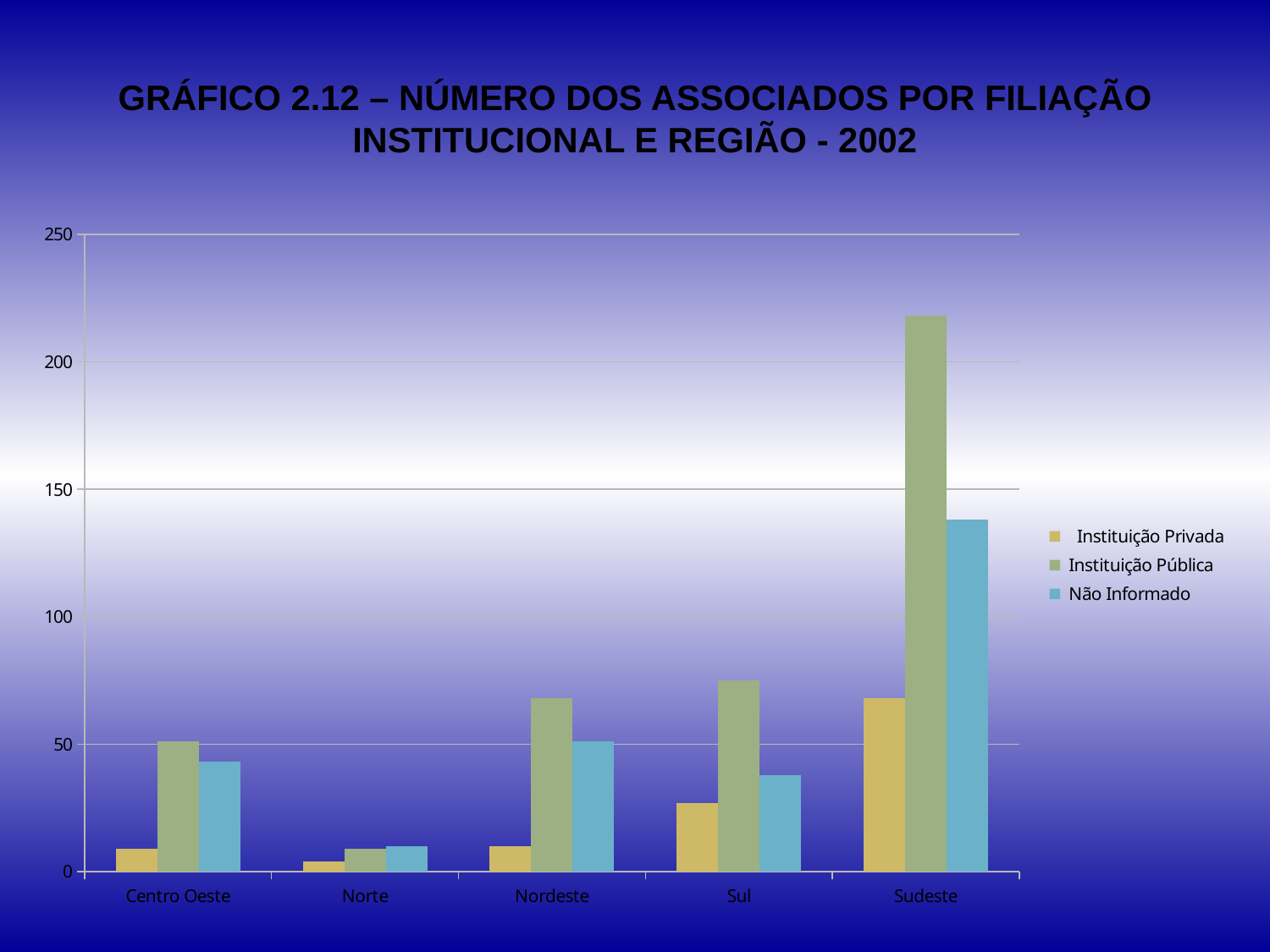
How many series does the legend list? 3 Which region has the lowest value for Instituição Privada? Norte Is the value for Instituição Pública in Sul greater or less than 50? greater In Sul, which is larger: Instituição Pública or Não Informado? Instituição Pública What colour represents Não Informado in the legend? blue Which region has the highest value for Instituição Pública? Sudeste Which region has the highest value for Não Informado? Sudeste Is the value for Instituição Pública in Sudeste greater or less than 200? greater How many regions are shown on the x axis? 5 In Sudeste, which is larger: Instituição Privada or Não Informado? Não Informado What kind of chart is shown on the slide? bar chart Is the value for Não Informado in Sudeste greater or less than 150? less